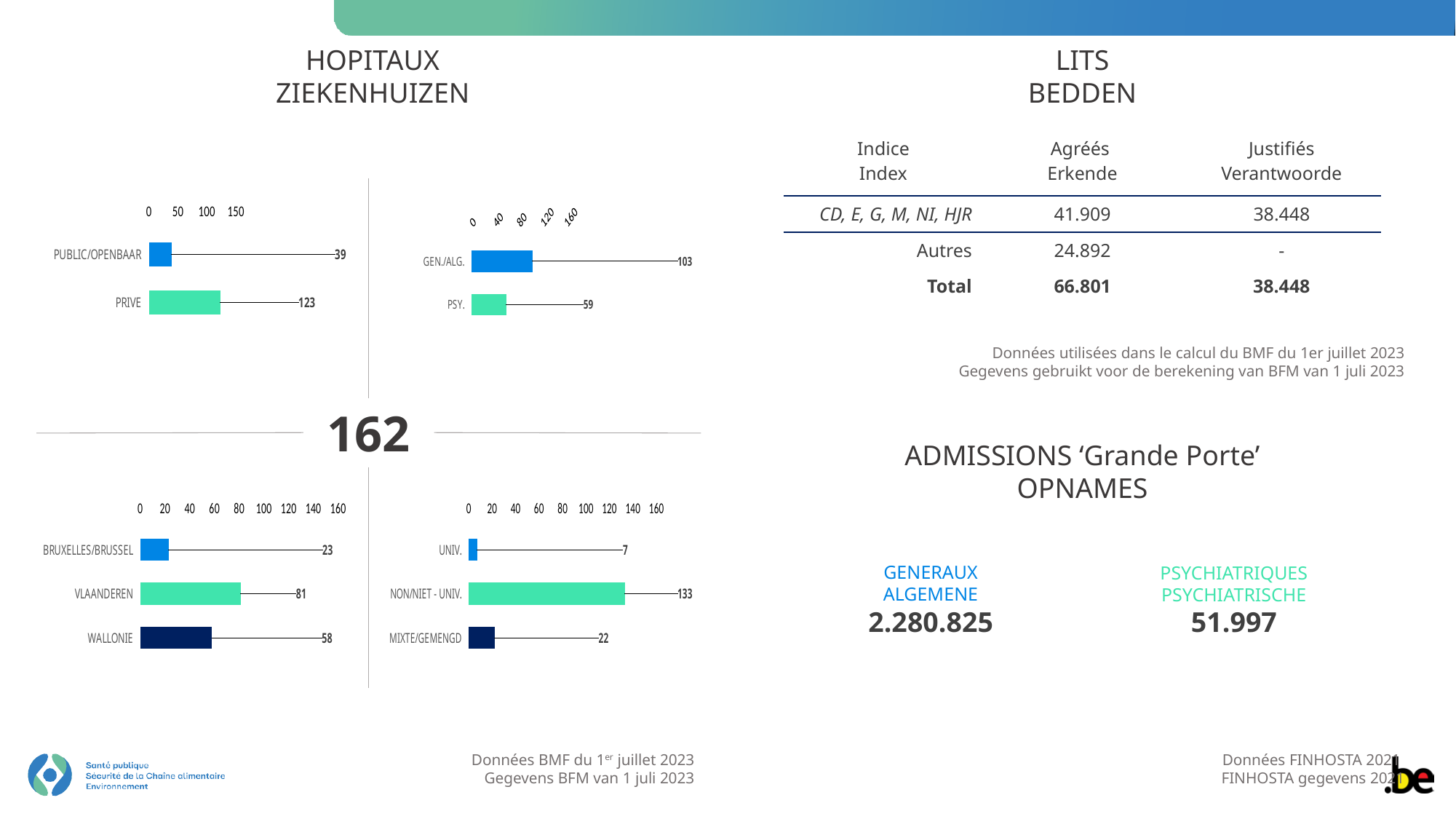
In the bottom-right bar chart, which is larger, UNIV. or MIXTE/GEMENGD? MIXTE/GEMENGD What kind of chart is the top-left chart? Bar chart In the top-right bar chart, what is the value for GEN./ALG.? 103 In the bottom-left bar chart, which category has the highest value? VLAANDEREN In the bottom-right bar chart, what is the value for NON/NIET - UNIV.? 133 In the top-left bar chart, what is the value for PUBLIC/OPENBAAR? 39 In the bottom-left bar chart, which category has the lowest value? BRUXELLES/BRUSSEL In the bottom-left bar chart, how many categories are shown? 3 In the top-left bar chart, what is the value for PRIVE? 123 In the top-right bar chart, what is the difference between GEN./ALG. and PSY.? 44 In the bottom-left bar chart, what is the value for WALLONIE? 58 In the bottom-right bar chart, what is the difference between NON/NIET - UNIV. and UNIV.? 126